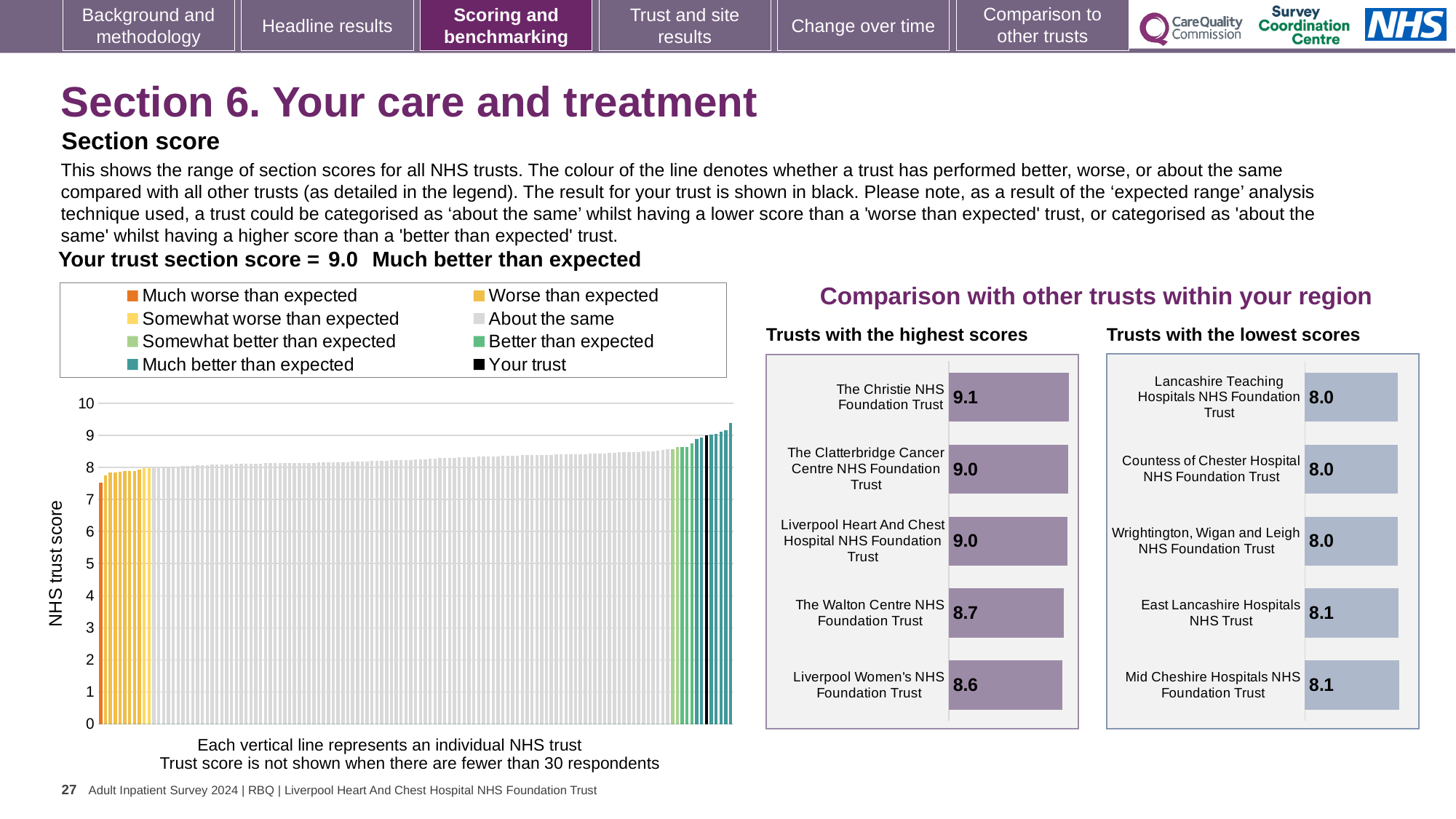
In the large 'NHS trust score' chart on the left, do the values rise or fall from left to right along the x axis? Rise In the 'Trusts with the lowest scores' chart, which is larger: the score for Mid Cheshire Hospitals NHS Foundation Trust or the score for Lancashire Teaching Hospitals NHS Foundation Trust? Mid Cheshire Hospitals NHS Foundation Trust In the 'Trusts with the highest scores' chart, which trust has the lowest score? Liverpool Women's NHS Foundation Trust In the 'Trusts with the highest scores' chart, how many trusts are shown? 5 In the 'Trusts with the highest scores' chart, what is the score for The Christie NHS Foundation Trust? 9.1 How many entries does the legend of the large 'NHS trust score' chart on the left list? 8 In the 'Trusts with the lowest scores' chart, what is the score for East Lancashire Hospitals NHS Trust? 8.1 In the 'Trusts with the highest scores' chart, which trust has the highest score? The Christie NHS Foundation Trust In the 'Trusts with the lowest scores' chart, what is the difference between the scores of Mid Cheshire Hospitals NHS Foundation Trust and Countess of Chester Hospital NHS Foundation Trust? 0.1 What kind of chart is the large 'NHS trust score' chart on the left of the slide? Bar chart In the 'Trusts with the highest scores' chart, what is the difference between the scores of The Christie NHS Foundation Trust and Liverpool Women's NHS Foundation Trust? 0.5 In the 'Trusts with the highest scores' chart, what is the score for The Walton Centre NHS Foundation Trust? 8.7